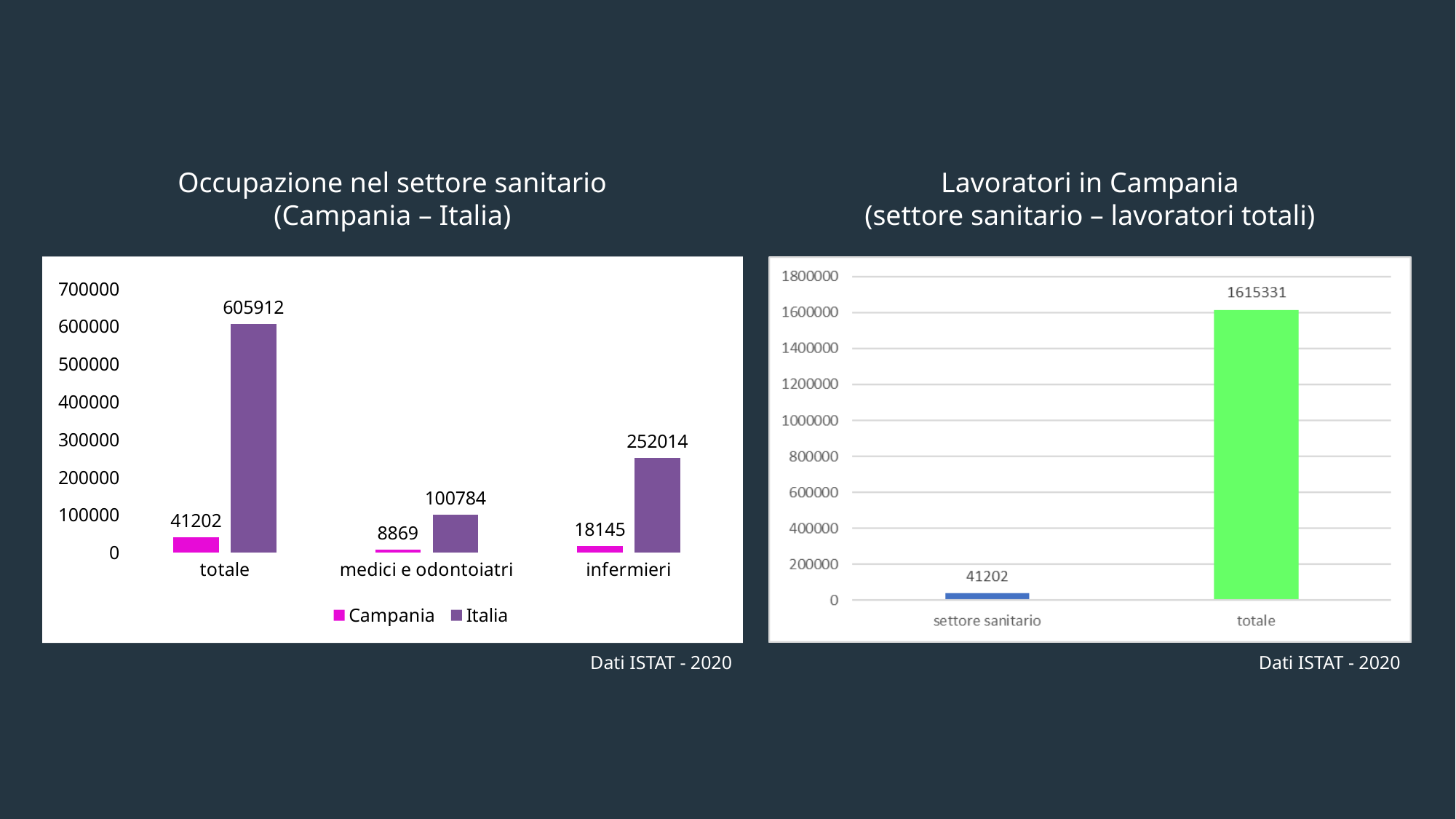
In the left chart 'Occupazione nel settore sanitario (Campania – Italia)', what is the value for Italia in the 'totale' category? 605912 What kind of chart is the right chart 'Lavoratori in Campania (settore sanitario – lavoratori totali)'? bar chart In the right chart 'Lavoratori in Campania (settore sanitario – lavoratori totali)', what is the difference between 'totale' and 'settore sanitario'? 1574129 In the left chart 'Occupazione nel settore sanitario (Campania – Italia)', which is larger: the Italia value for 'medici e odontoiatri' or the Italia value for 'infermieri'? infermieri In the left chart 'Occupazione nel settore sanitario (Campania – Italia)', how many series does the legend list? 2 In the left chart 'Occupazione nel settore sanitario (Campania – Italia)', what is the difference between the Italia and Campania values for 'infermieri'? 233869 In the left chart 'Occupazione nel settore sanitario (Campania – Italia)', what is the value for Italia in the 'infermieri' category? 252014 In the left chart 'Occupazione nel settore sanitario (Campania – Italia)', how many categories are shown on the x axis? 3 In the left chart 'Occupazione nel settore sanitario (Campania – Italia)', which category has the lowest Campania value? medici e odontoiatri In the right chart 'Lavoratori in Campania (settore sanitario – lavoratori totali)', what is the value for 'totale'? 1615331 In the left chart 'Occupazione nel settore sanitario (Campania – Italia)', what colour are the Campania bars? magenta In the left chart 'Occupazione nel settore sanitario (Campania – Italia)', what is the value for Campania in the 'medici e odontoiatri' category? 8869